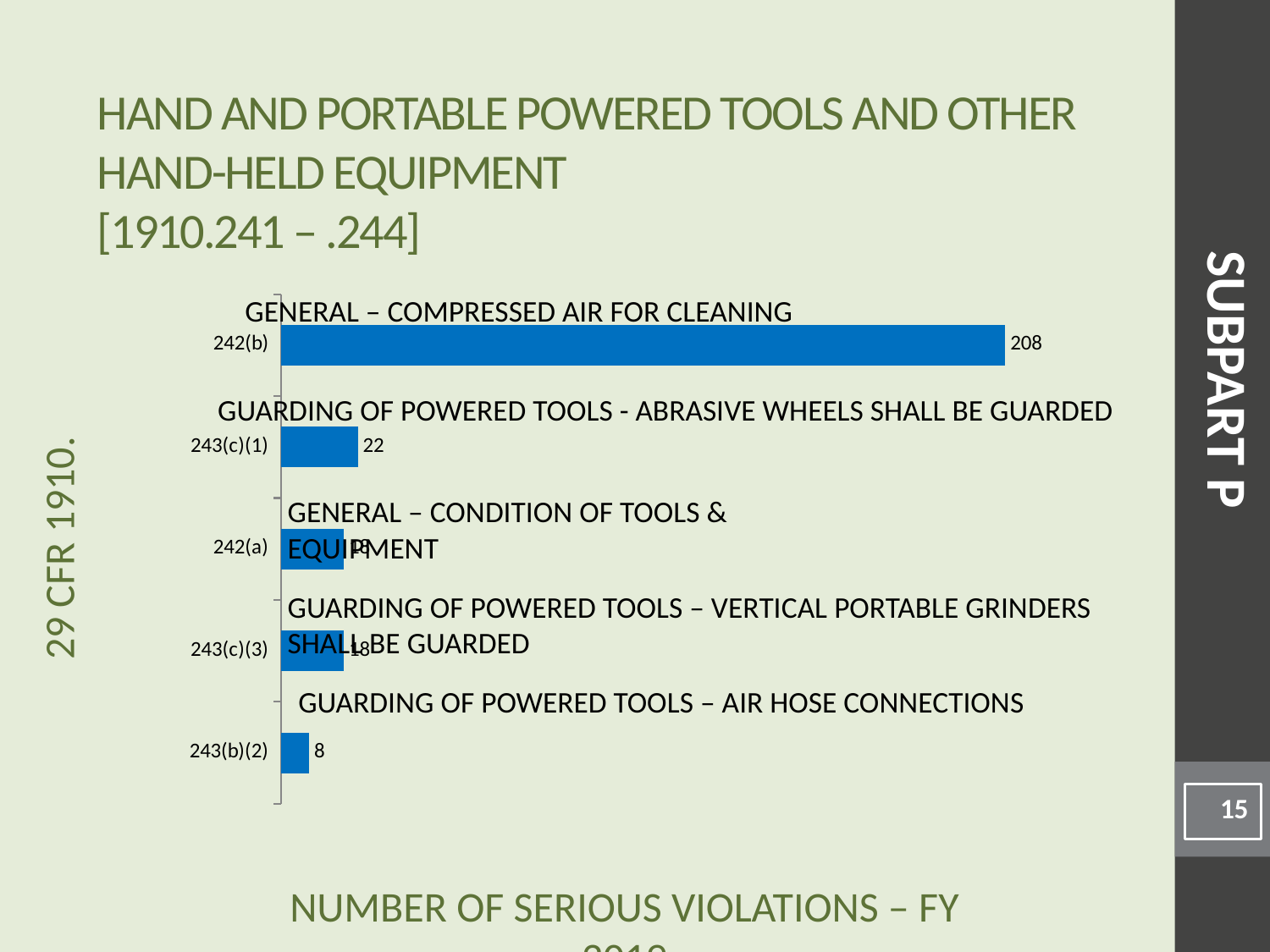
How many standards (categories) are shown in the chart? 5 What is the difference between the violations for 242(b) and 243(c)(1)? 186 What kind of chart is shown on the slide? Bar chart Which standard has the highest number of serious violations? 242(b) What description is given for the 242(b) bar? GENERAL – COMPRESSED AIR FOR CLEANING Which has more serious violations, 243(c)(1) or 243(b)(2)? 243(c)(1) What is the number of serious violations for 242(b)? 208 Which standard has the lowest number of serious violations? 243(b)(2) What is the difference between the violations for 243(c)(1) and 243(b)(2)? 14 Which has more serious violations, 242(b) or 243(c)(1)? 242(b) What is the number of serious violations for 243(b)(2)? 8 What is the number of serious violations for 243(c)(1)? 22